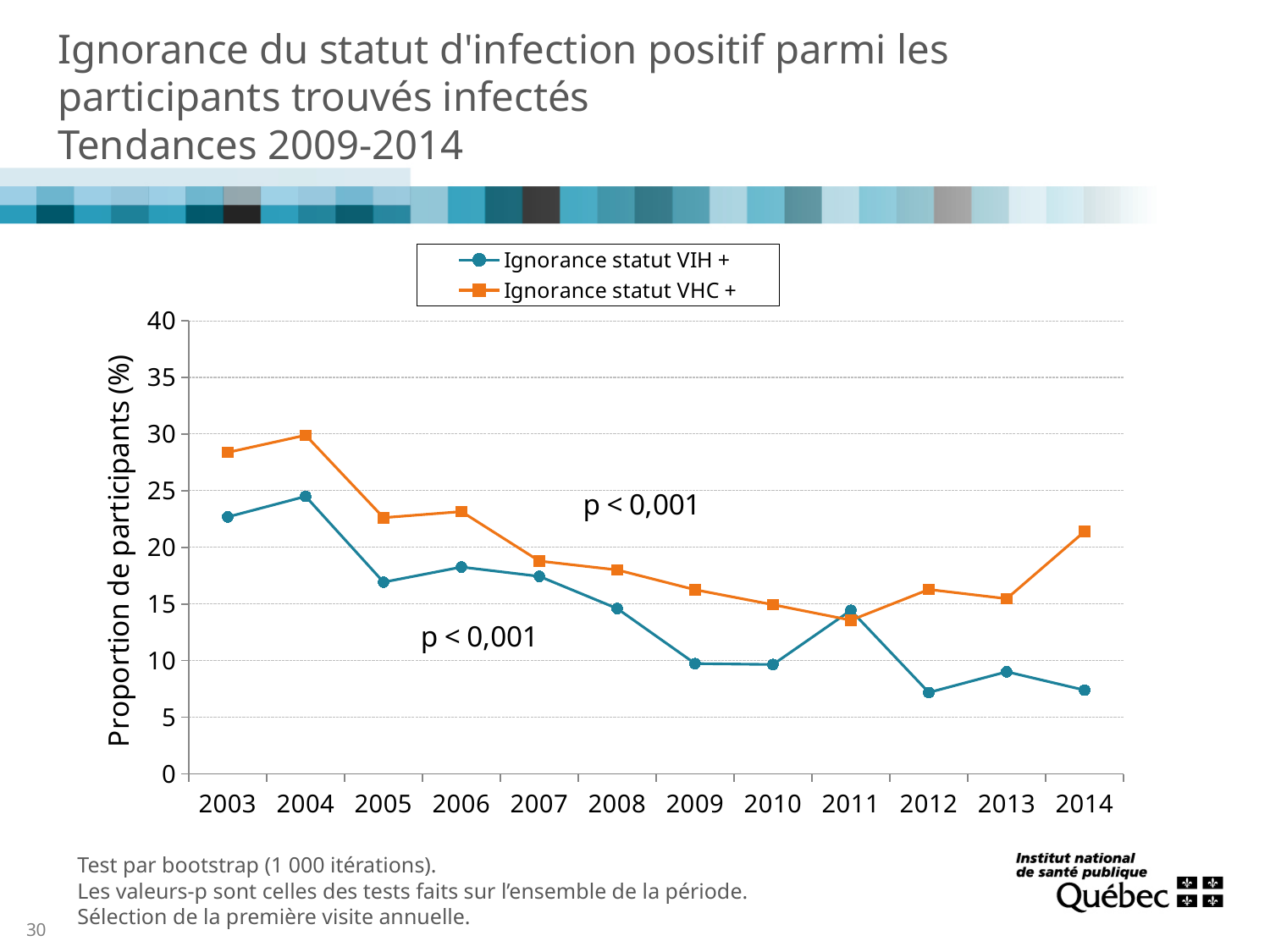
In 2003, which series has the larger value, 'Ignorance statut VIH +' or 'Ignorance statut VHC +'? Ignorance statut VHC + What kind of chart is shown on the slide? line chart Is the value for 'Ignorance statut VHC +' in 2014 greater or less than 20? greater Is the value for 'Ignorance statut VIH +' in 2012 greater or less than 10? less Does the 'Ignorance statut VIH +' series overall rise or fall from 2003 to 2014? fall Is the value for 'Ignorance statut VHC +' in 2004 greater or less than 25? greater How many series does the legend list? 2 In which year does the 'Ignorance statut VIH +' series reach its highest value? 2004 What is the label of the y axis? Proportion de participants (%) How many years are plotted along the x axis? 12 In which year does the 'Ignorance statut VHC +' series reach its lowest value? 2011 In which year does the 'Ignorance statut VHC +' series reach its highest value? 2004